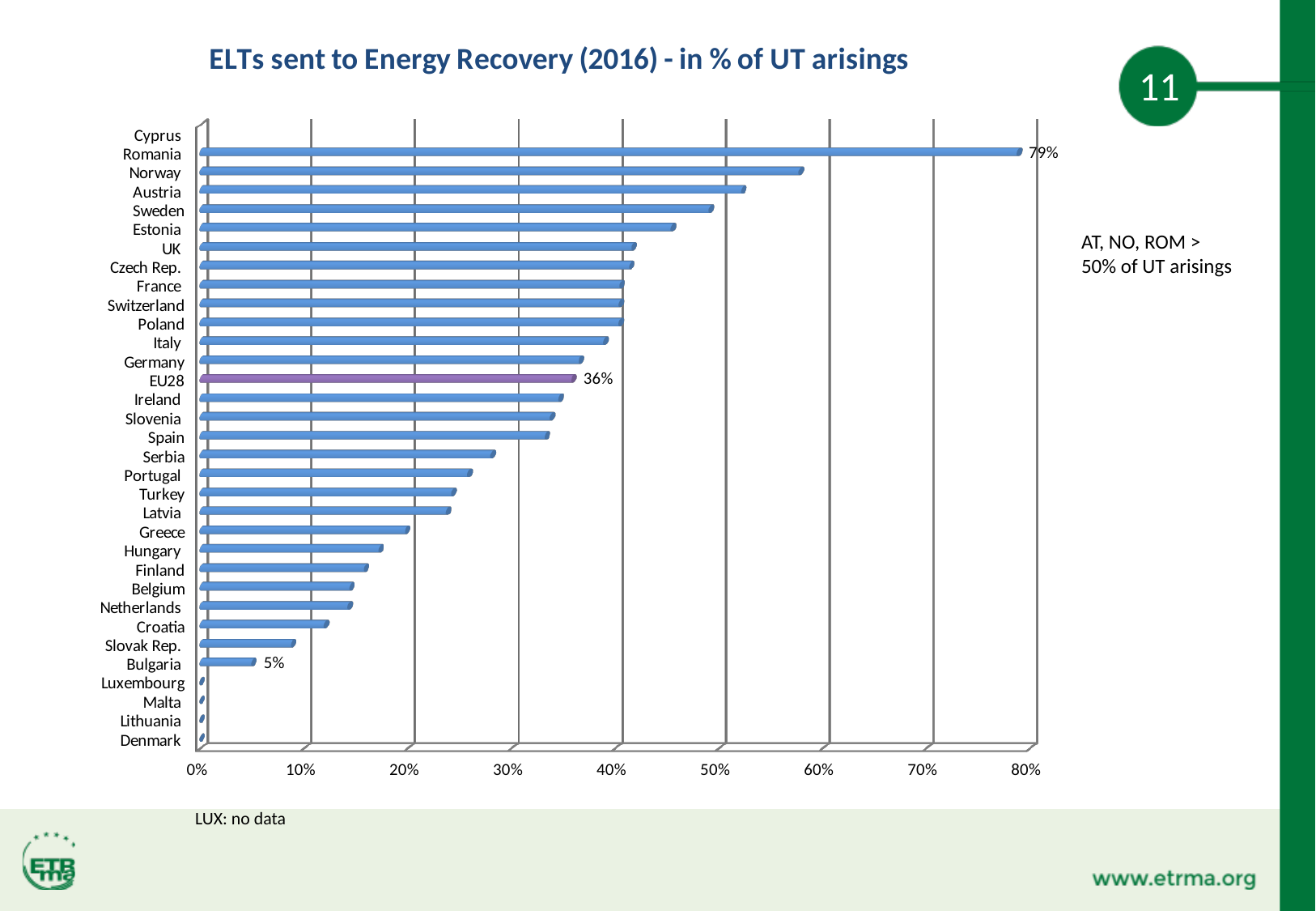
Is the value for Estonia greater or less than 40%? greater How many categories are listed on the vertical axis of the chart? 33 Is the value for Hungary greater or less than 20%? less What value is labelled for Bulgaria? 5% What is the title of the chart? ELTs sent to Energy Recovery (2016) - in % of UT arisings What is the highest value labelled on the chart? 79% What type of chart is shown on the slide? Bar chart What is the difference between the EU28 value and the Bulgaria value? 31% What is the difference between the highest labelled value (79%) and the EU28 value? 43% What value is labelled for EU28? 36% Which has the larger value, Norway or Austria? Norway Is the value for Norway greater or less than 50%? greater